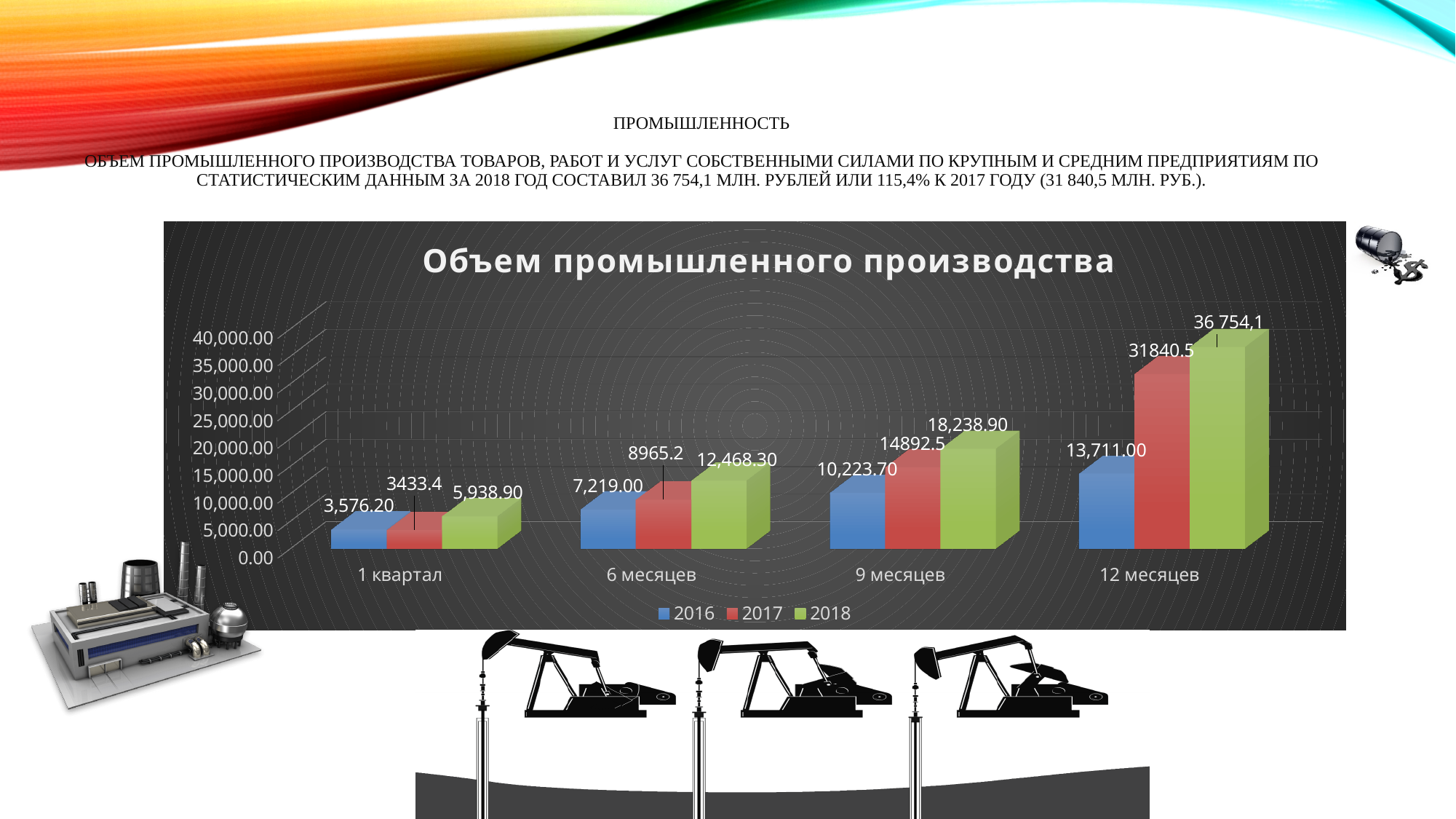
How many series does the legend list? 3 How many categories are shown on the x axis? 4 What is the value for 2017 in the 6 месяцев category? 8965.2 What kind of chart is shown? bar chart Which category has the lowest value for the 2016 series? 1 квартал What is the value for 2018 in the 12 месяцев category? 36 754,1 What is the difference between the 2018 and 2017 values in the 12 месяцев category? 4913.6 Which category has the highest value for the 2017 series? 12 месяцев What is the value for 2018 in the 1 квартал category? 5,938.90 What is the value for 2016 in the 9 месяцев category? 10,223.70 Which is larger in the 1 квартал category: the 2016 value or the 2017 value? 2016 Do the values for the 2018 series rise or fall from 1 квартал to 12 месяцев? rise